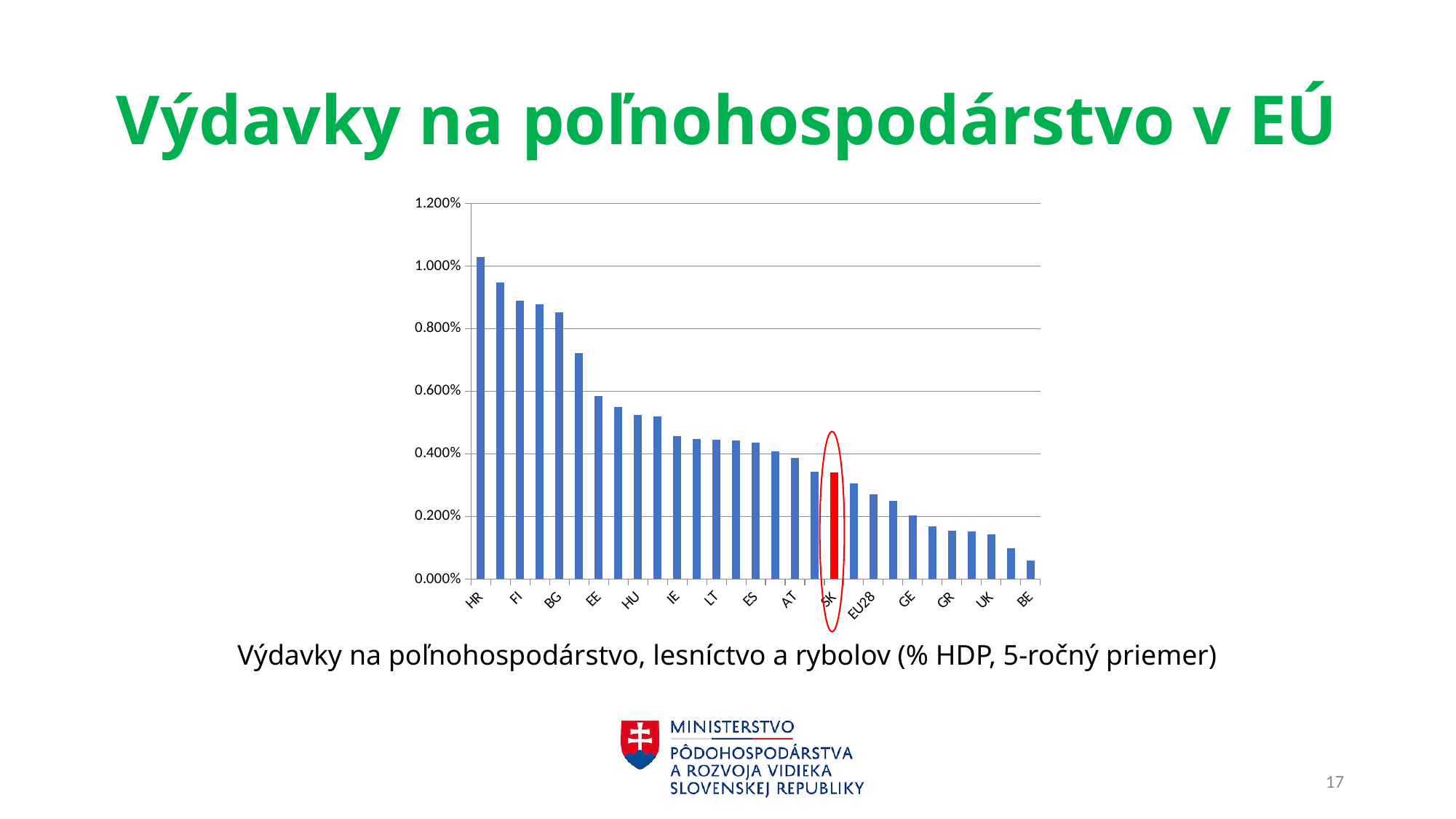
Which is larger, the value for SK or the value for EU28? SK Is the value for GR greater or less than 0.200%? less Is the value for HR greater or less than 1.000%? greater Do the values rise or fall from left to right along the x axis? fall Which category has the highest value in the chart? HR Is the value for BG greater or less than 0.800%? greater Which category's bar is highlighted in red and circled? SK Which is larger, the value for HU or the value for GE? HU What kind of chart is shown on the slide? bar chart Which category has the lowest value in the chart? BE